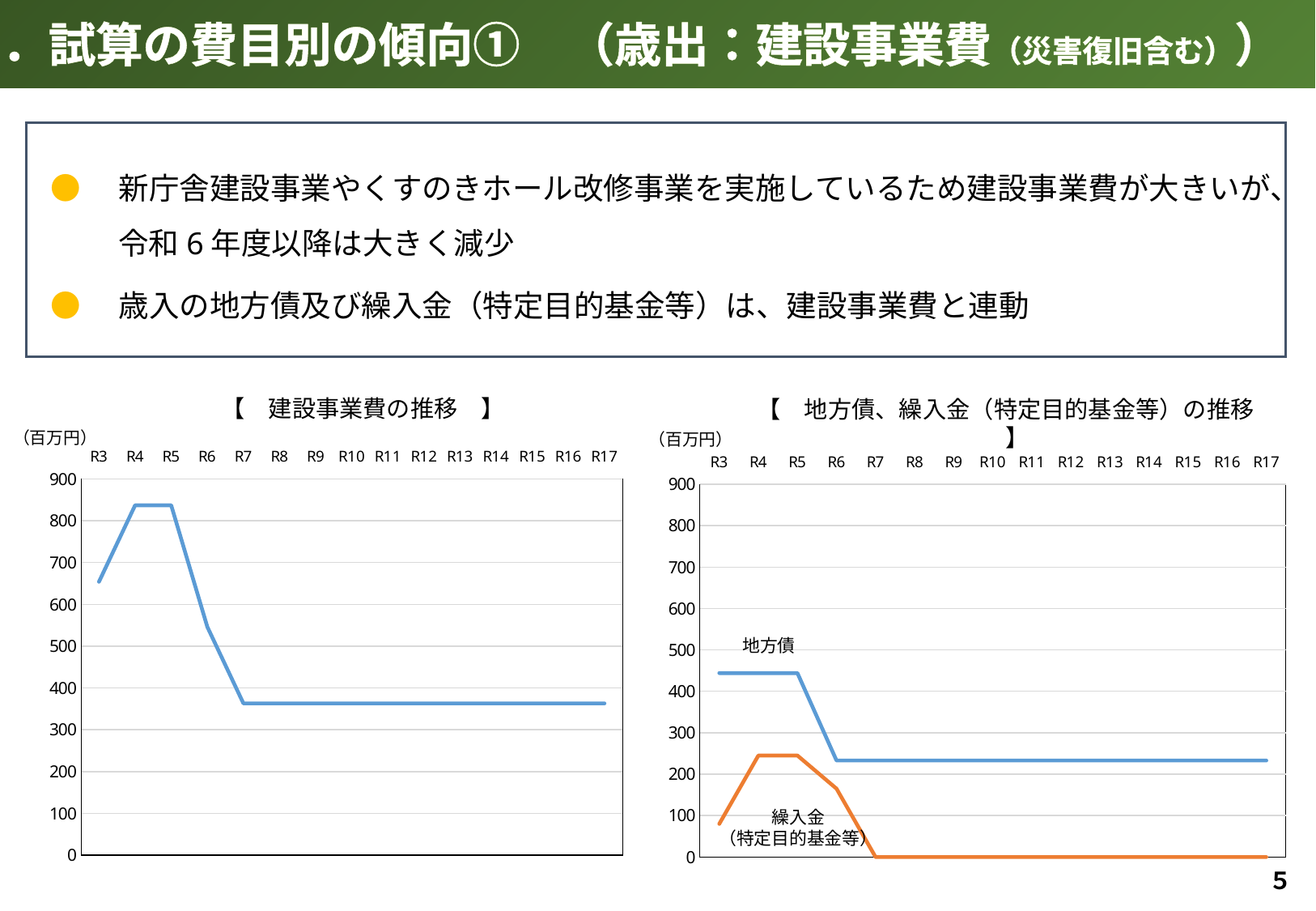
In the left chart (建設事業費の推移), is the value for R3 greater or less than 600? greater In the left chart (建設事業費の推移), which is larger, the value for R5 or the value for R6? R5 In the left chart (建設事業費の推移), is the value for R10 greater or less than 400? less In the right chart (地方債、繰入金の推移), is the value of 地方債 for R3 greater or less than 400? greater In the left chart (建設事業費の推移), how many fiscal years are plotted along the x axis? 15 In the right chart (地方債、繰入金の推移), how many series are plotted? 2 In the left chart (建設事業費の推移), do the values rise or fall from R5 to R7? fall In the right chart (地方債、繰入金の推移), which series has the higher value at R10, 地方債 or 繰入金（特定目的基金等）? 地方債 What unit is shown for the y axis of the left chart (建設事業費の推移)? 百万円 What kind of chart is the left chart titled 建設事業費の推移? line chart